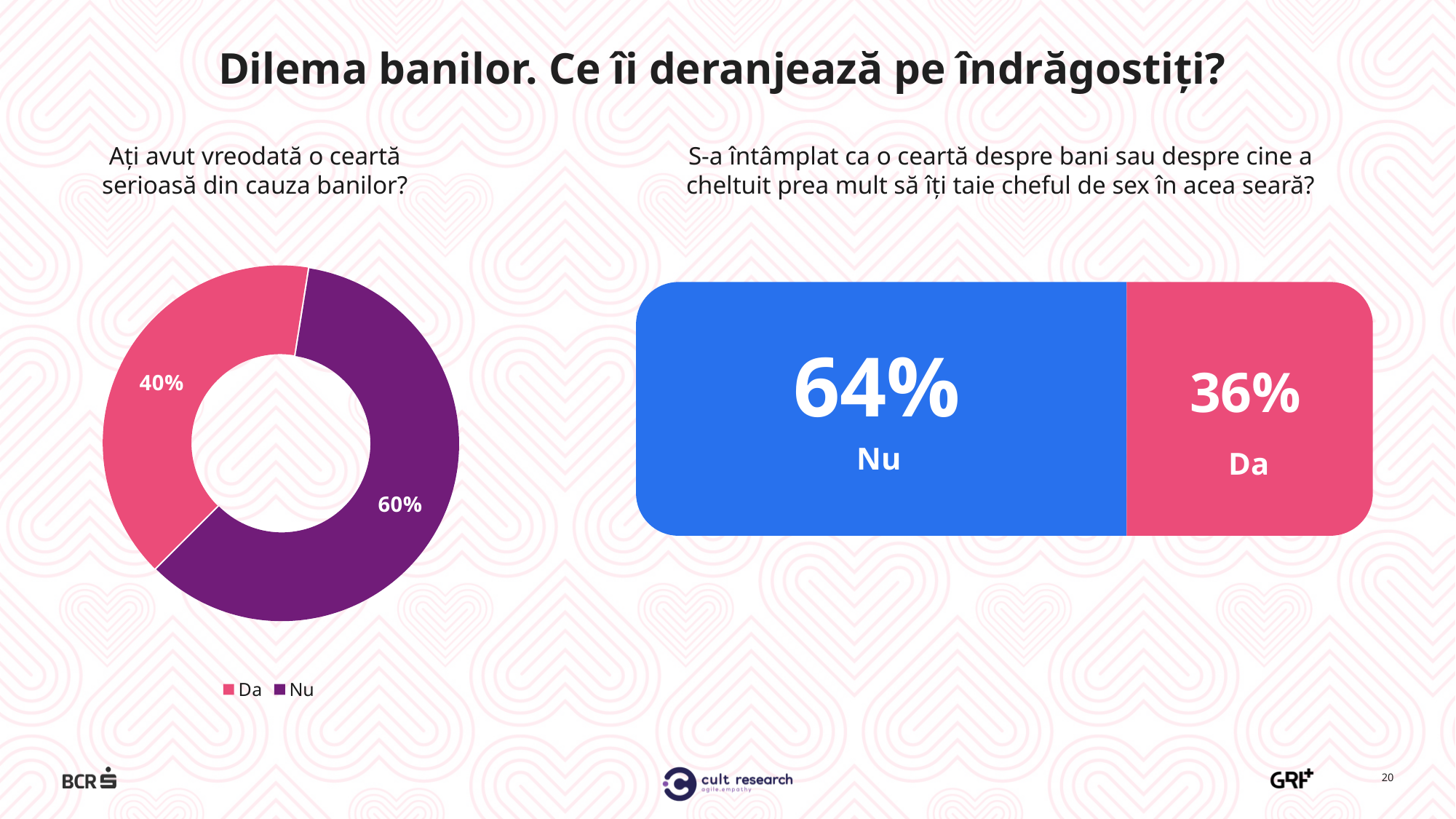
In the bar chart on the right, what is the difference in percentage points between "Nu" and "Da"? 28 In the donut chart on the left, which colour represents "Da"? Pink In the donut chart on the left, which answer has the larger share? Nu In the donut chart on the left, what is the difference in percentage points between "Nu" and "Da"? 20 In the donut chart on the left, what share of respondents answered "Nu"? 60% In the bar chart on the right, what percentage answered "Da"? 36% What type of chart is shown on the left of the slide? Donut (pie) chart In the bar chart on the right, which answer has the smaller share? Da In the bar chart on the right, what do the two segments add up to? 100% In the bar chart on the right, what percentage answered "Nu"? 64% How many entries does the legend of the donut chart on the left list? 2 In the donut chart on the left, what share of respondents answered "Da"? 40%